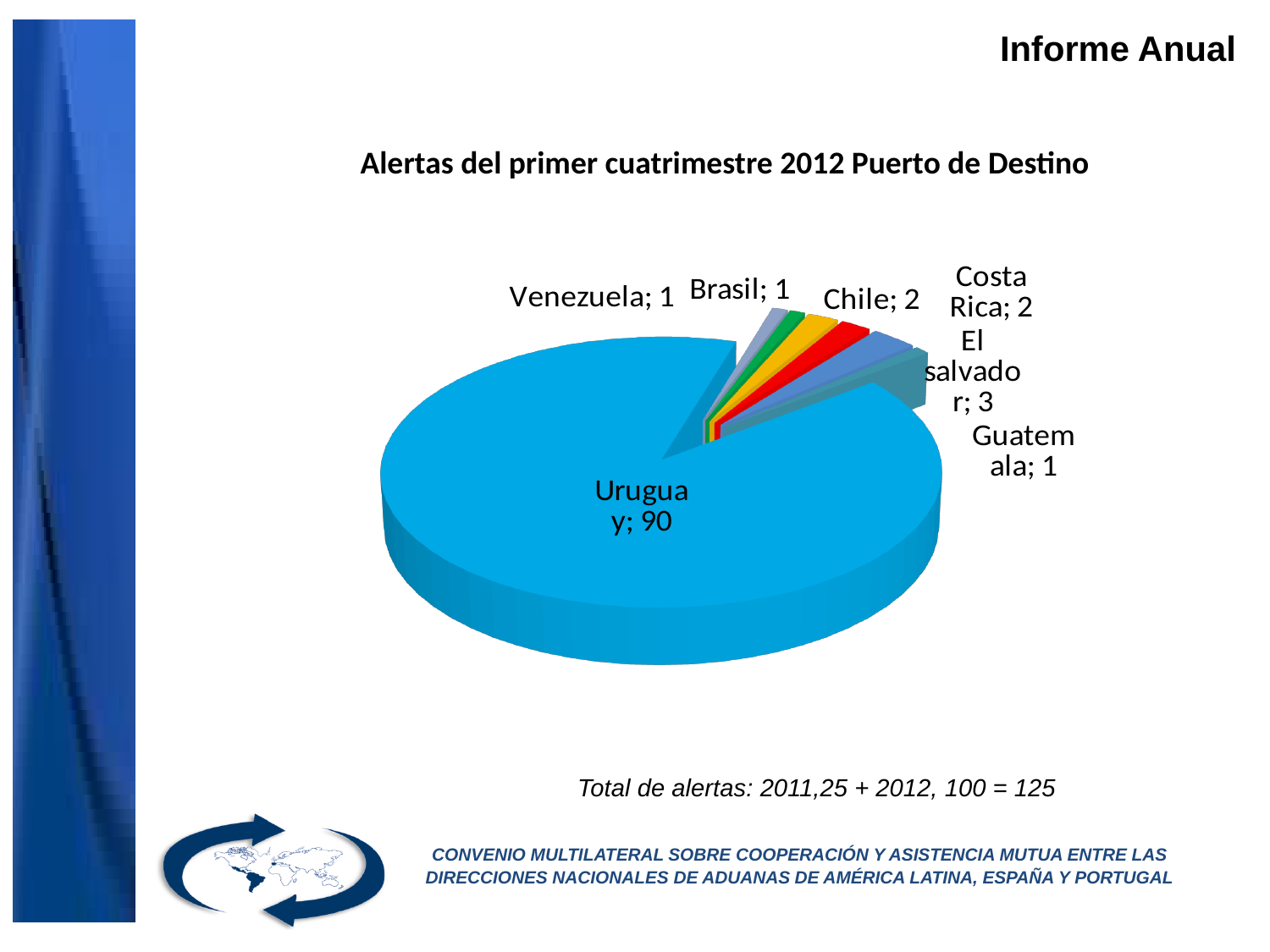
How many alerts are shown for Guatemala? 1 How many alerts are shown for Uruguay? 90 What share of the pie does Uruguay represent? 90% What is the total of all the slices in the pie chart? 100 What is the difference between the values for Uruguay and El salvador? 87 How many alerts are shown for Chile? 2 Which destination port has the largest slice of the pie? Uruguay How many categories (slices) does the pie chart have? 7 What type of chart is shown on the slide? Pie chart What is the title of the chart? Alertas del primer cuatrimestre 2012 Puerto de Destino Which has a larger value, El salvador or Costa Rica? El salvador How many alerts are shown for El salvador? 3